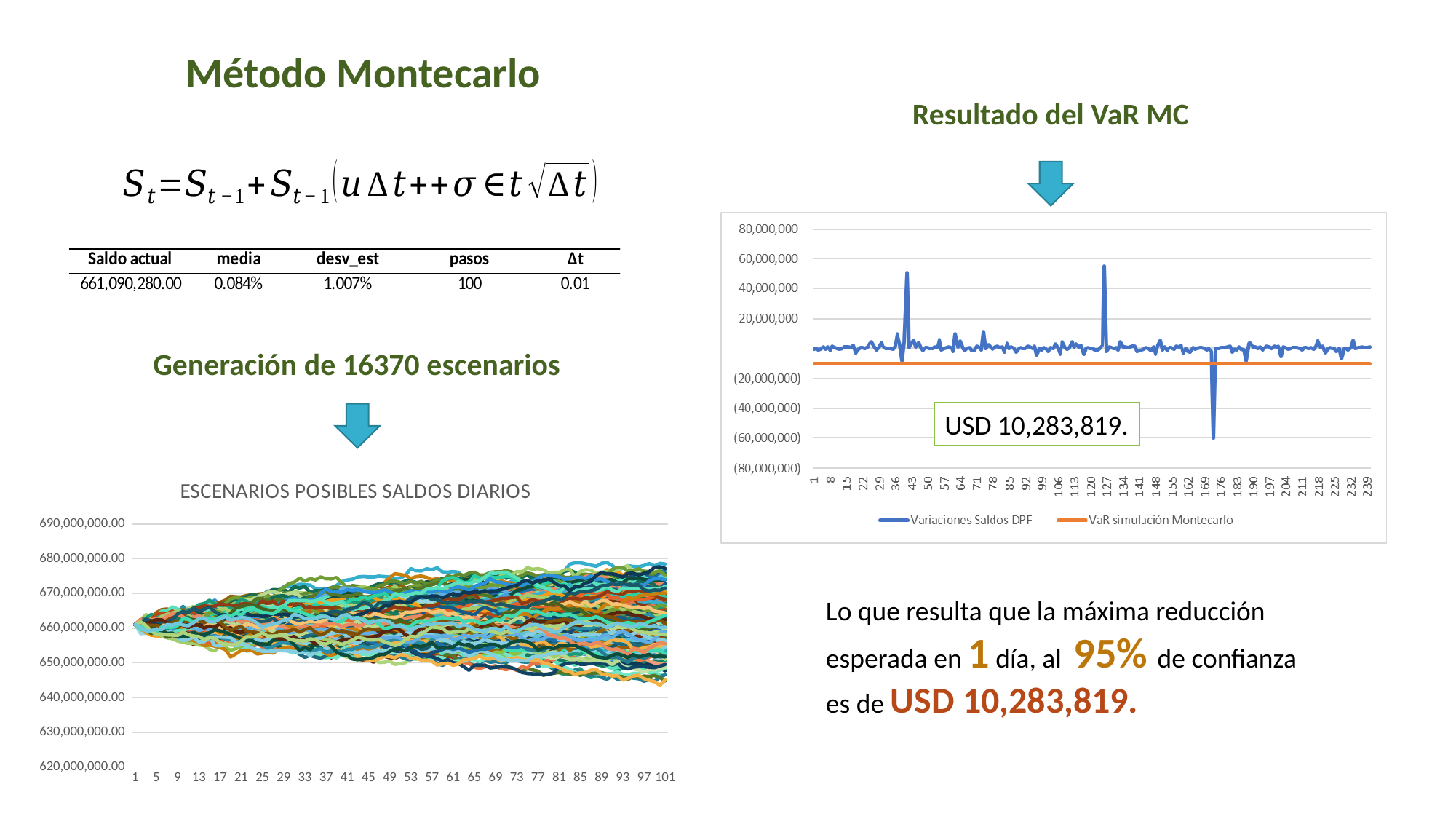
In the right-hand chart, is the 'VaR simulación Montecarlo' line greater or less than 0? less In the right-hand chart, is the 'VaR simulación Montecarlo' line greater or less than (20,000,000)? greater In the right-hand chart, which series has the larger value at point 127: 'Variaciones Saldos DPF' or 'VaR simulación Montecarlo'? Variaciones Saldos DPF In the chart 'ESCENARIOS POSIBLES SALDOS DIARIOS', are the scenario values at step 101 greater or less than 640,000,000.00? greater In the right-hand chart, what are the two series named in the legend? Variaciones Saldos DPF and VaR simulación Montecarlo What kind of chart is the chart titled 'ESCENARIOS POSIBLES SALDOS DIARIOS'? line chart In the chart 'ESCENARIOS POSIBLES SALDOS DIARIOS', what is the highest value shown on the y axis? 690,000,000.00 In the right-hand chart, what colour is the 'VaR simulación Montecarlo' line? orange What kind of chart is the chart on the right under 'Resultado del VaR MC'? line chart How many series does the legend of the right-hand chart list? 2